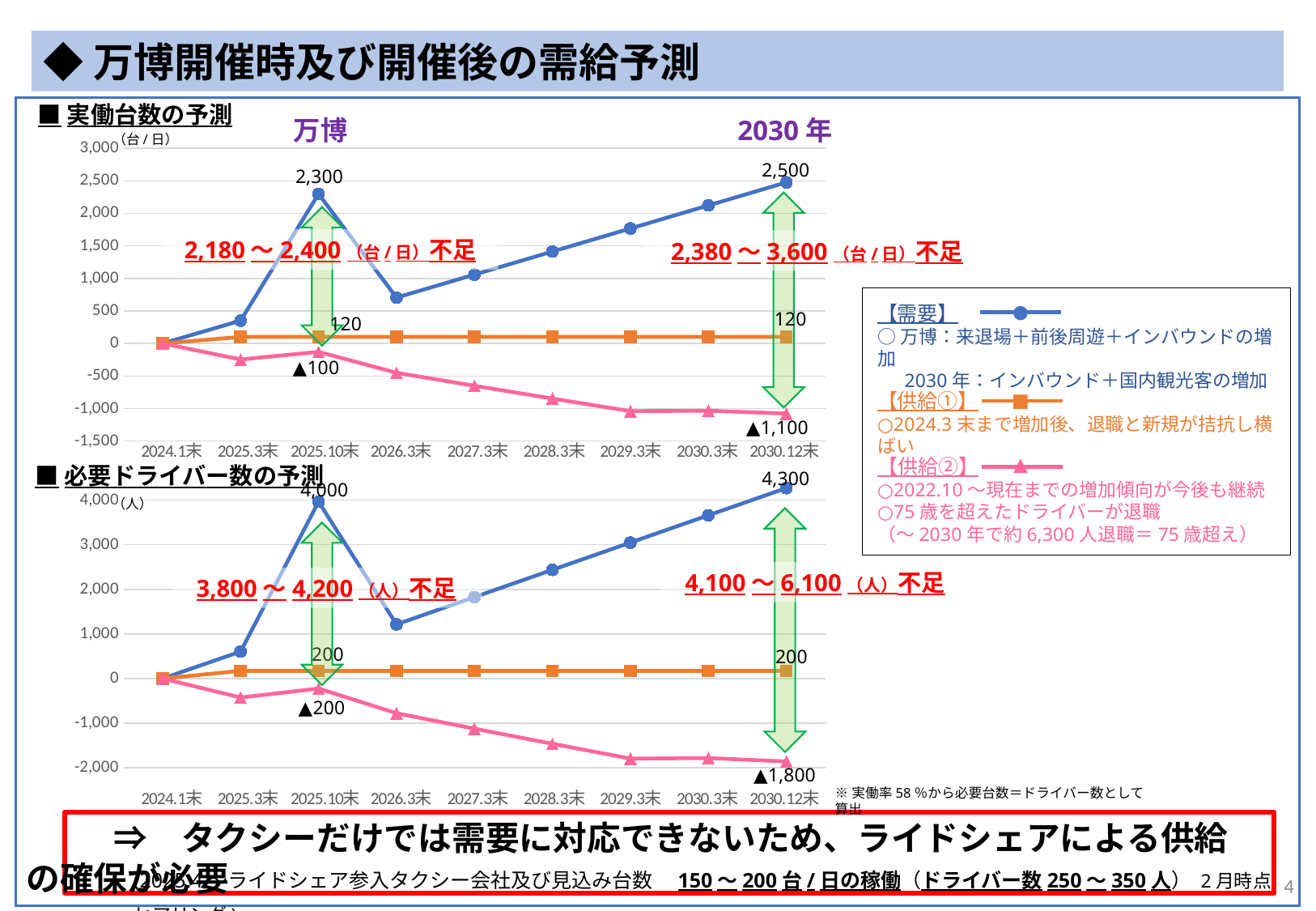
How many series does the legend list for the charts? 3 In the top chart (実働台数の予測), what is the value of the 供給① series at 2030.12末? 120 In the top chart (実働台数の予測), what is the value of the 供給② series at 2030.12末? ▲1,100 In the bottom chart (必要ドライバー数の予測), is the 需要 value at 2028.3末 greater or less than 2,000? greater In the top chart (実働台数の予測), what is the value of the 需要 series at 2025.10末? 2,300 How many time points are shown on the x axis of the top chart (実働台数の予測)? 9 In the bottom chart (必要ドライバー数の予測), what is the value of the 供給② series at 2030.12末? ▲1,800 In the bottom chart (必要ドライバー数の予測), what is the value of the 需要 series at 2025.10末? 4,000 What kind of chart is the bottom chart (必要ドライバー数の予測)? line chart In the top chart (実働台数の予測), what is the value of the 需要 series at 2030.12末? 2,500 In the bottom chart (必要ドライバー数の予測), what is the difference between the 需要 value at 2030.12末 and the 需要 value at 2025.10末? 300 In the top chart (実働台数の予測), which series has the higher value at 2030.12末, 需要 or 供給①? 需要